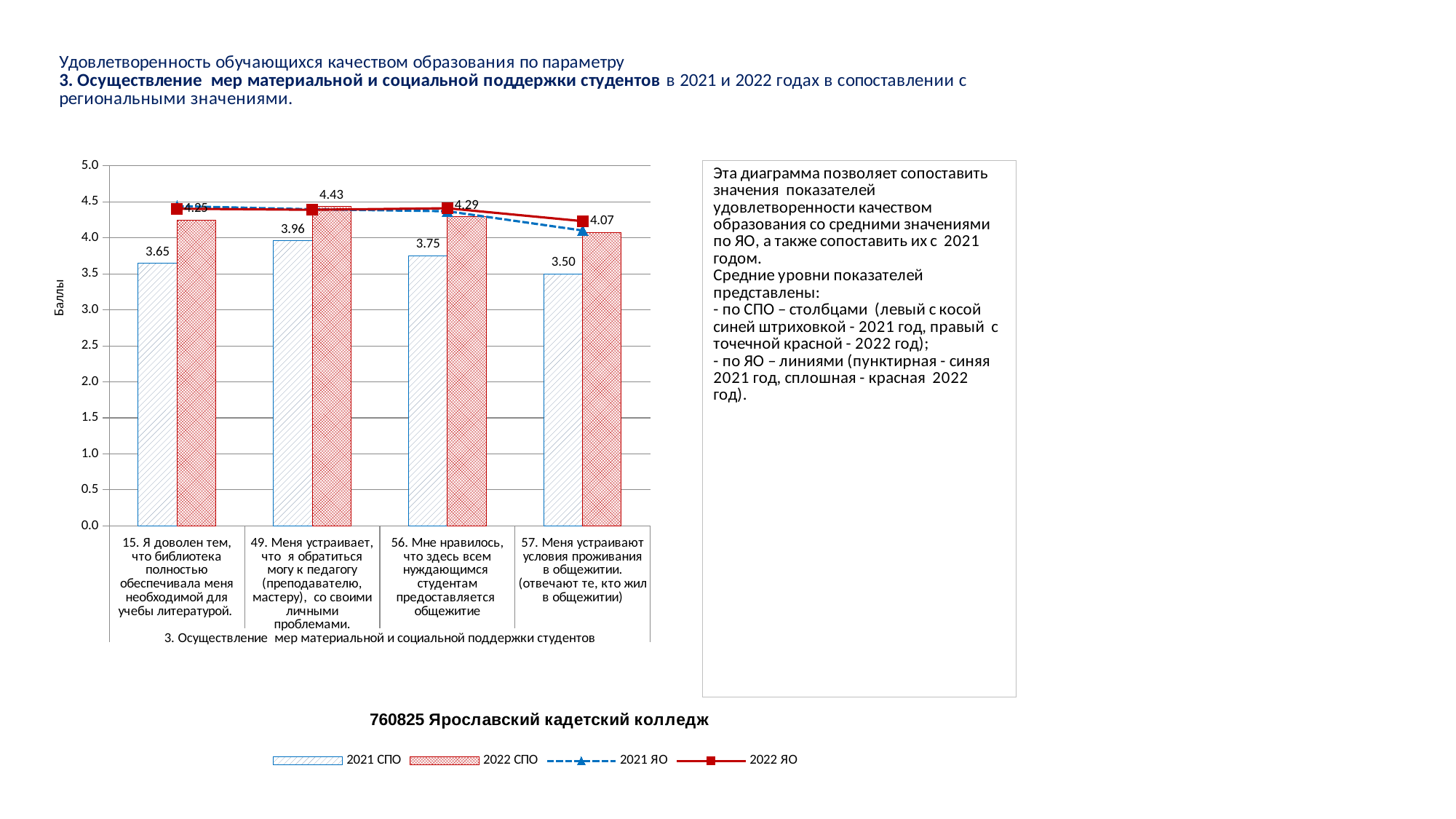
What is the 2022 СПО value for question 49 (about being able to approach a teacher with personal problems)? 4.43 Which is larger for question 57: the 2021 СПО value or the 2022 СПО value? 2022 СПО Which category has the lowest 2021 СПО value? 57. Меня устраивают условия проживания в общежитии. (отвечают те, кто жил в общежитии) What is the label of the vertical axis of the chart? Баллы Is the 2021 ЯО value for question 57 greater or less than 4.5? less How many series does the chart legend list? 4 How many categories are shown on the x axis of the chart? 4 What is the 2022 СПО value for question 56 (about dormitory being provided to all students in need)? 4.29 What is the 2021 СПО value for question 15 (about the library providing necessary literature)? 3.65 What is the difference between the 2022 СПО and 2021 СПО values for question 15? 0.60 Which category has the highest 2022 СПО value? 49. Меня устраивает, что я обратиться могу к педагогу (преподавателю, мастеру), со своими личными проблемами. What is the 2021 СПО value for question 57 (about living conditions in the dormitory)? 3.50